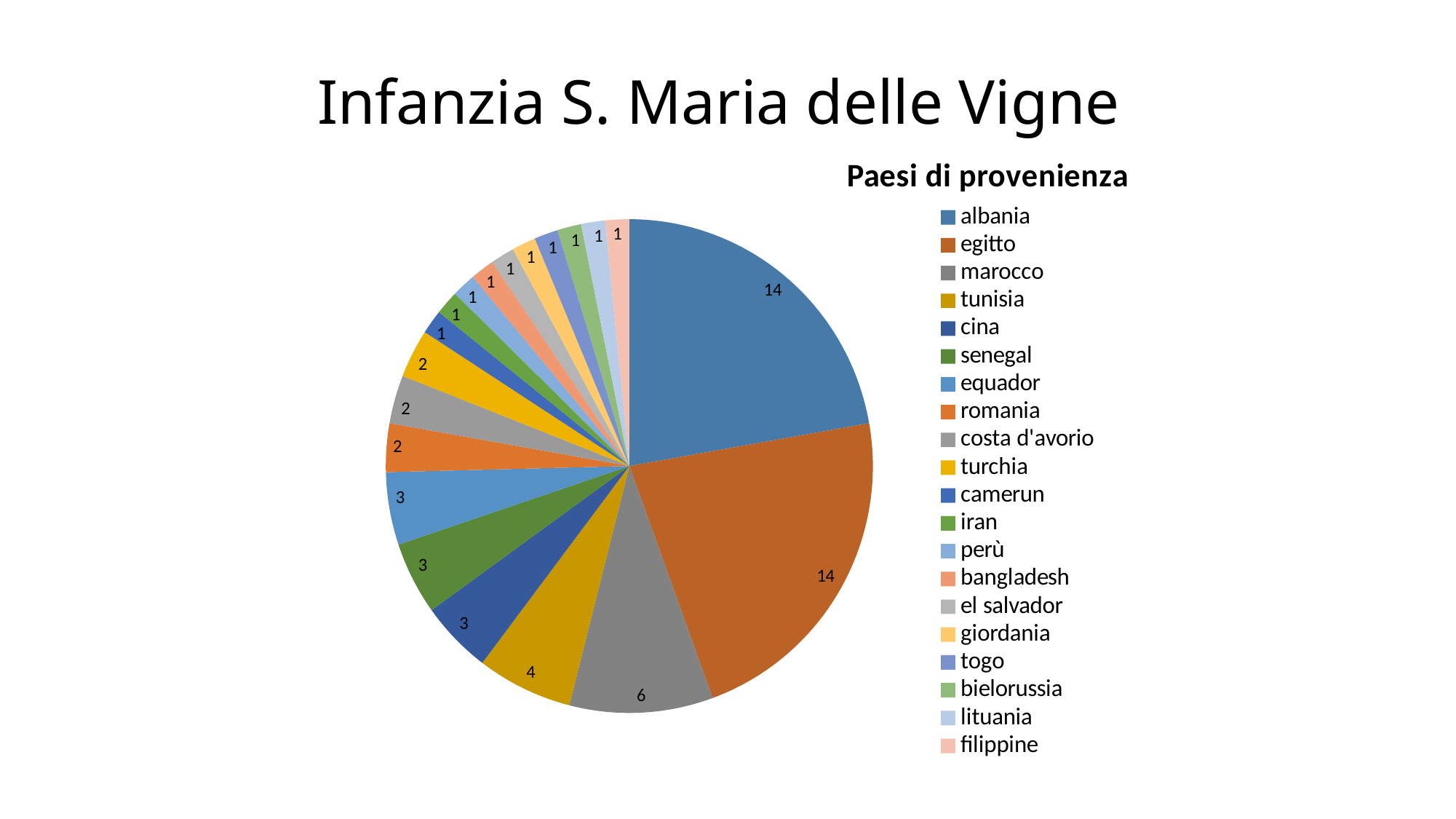
What kind of chart is shown on the slide? pie chart What is the value for cina in the pie chart? 3 What is the difference between the values for egitto and marocco? 8 What is the total of all the values shown in the pie chart? 63 What is the title of the chart? Paesi di provenienza Which has a larger value, senegal or turchia? senegal What is the value for tunisia in the pie chart? 4 What is the value for albania in the pie chart? 14 How many countries are listed in the chart legend? 20 What is the value for marocco in the pie chart? 6 What is the value for romania in the pie chart? 2 What is the difference between the values for tunisia and costa d'avorio? 2